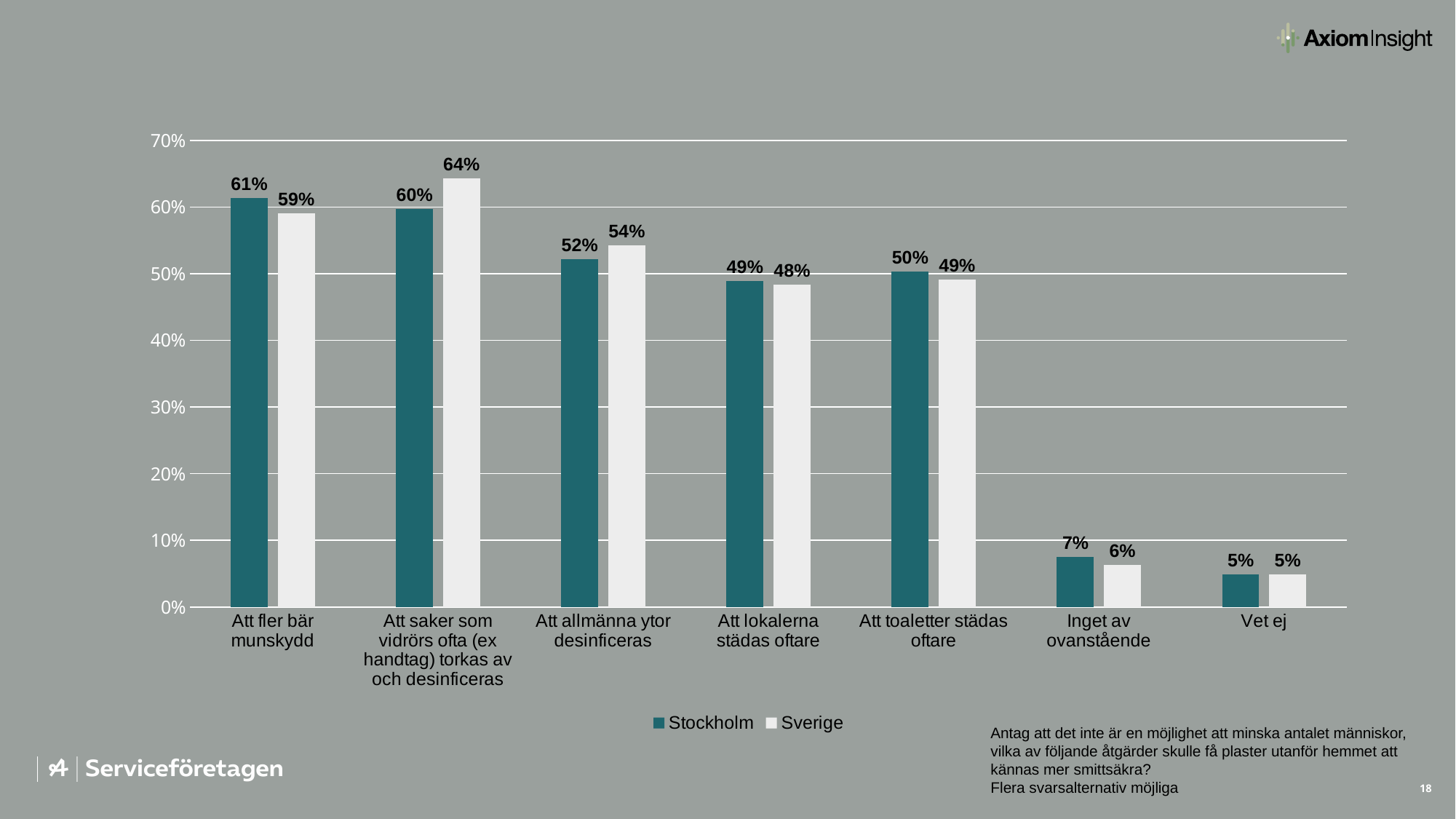
For "Att allmänna ytor desinficeras", which is larger: the Stockholm value or the Sverige value? Sverige What kind of chart is shown on the slide? Bar chart Which category has the lowest Stockholm value? Vet ej What are the two series named in the legend? Stockholm and Sverige What is the Stockholm value for "Att fler bär munskydd"? 61% Which category has the highest Sverige value? Att saker som vidrörs ofta (ex handtag) torkas av och desinficeras How many series does the legend list? 2 What is the Sverige value for "Att saker som vidrörs ofta (ex handtag) torkas av och desinficeras"? 64% What is the Stockholm value for "Inget av ovanstående"? 7% What is the difference between the Sverige and Stockholm values for "Att saker som vidrörs ofta (ex handtag) torkas av och desinficeras"? 4% What is the Sverige value for "Att allmänna ytor desinficeras"? 54% How many categories are shown on the x axis? 7